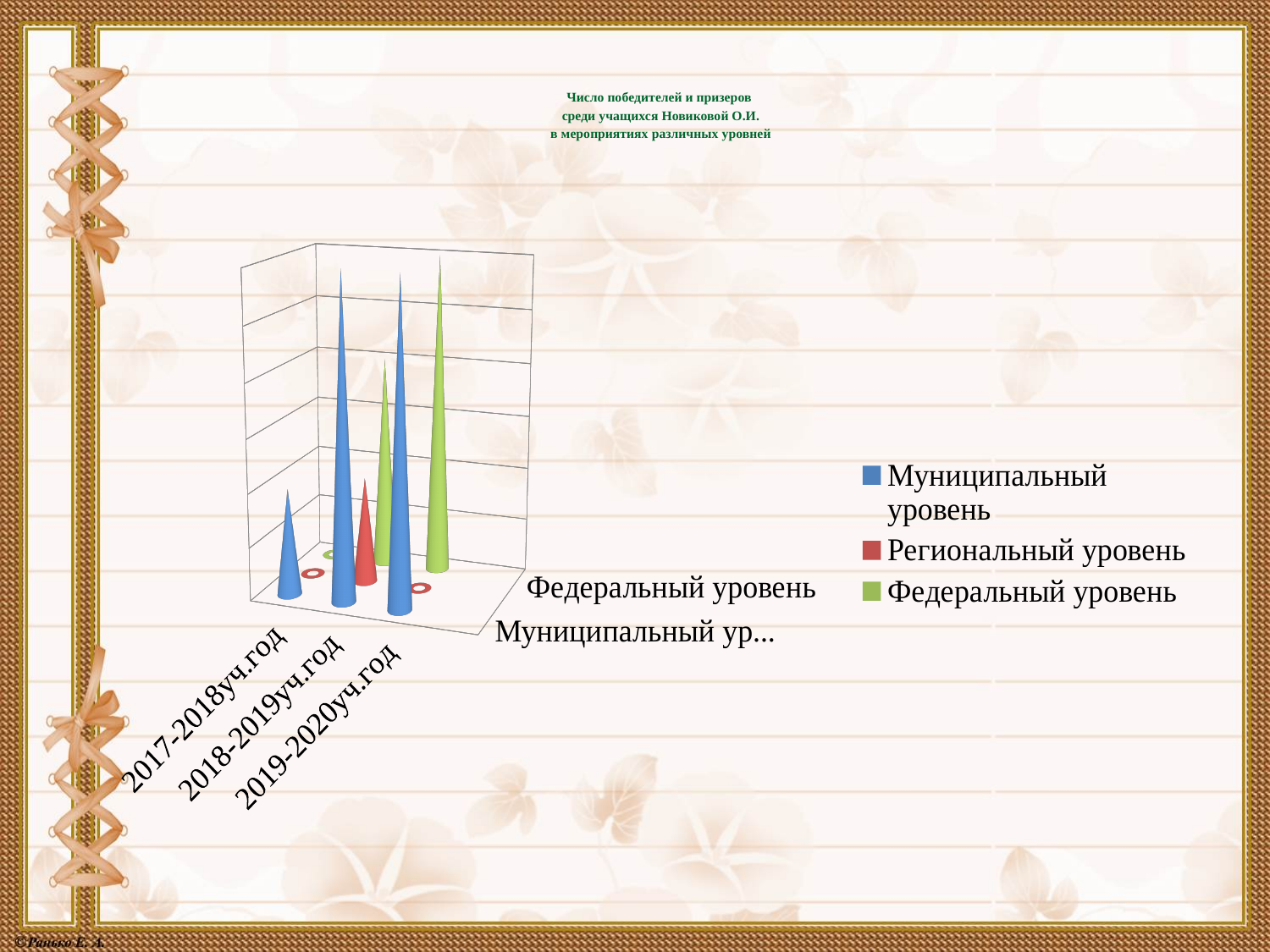
Does the Федеральный уровень value rise or fall from 2017-2018уч.год to 2018-2019уч.год? rises How many series does the chart legend list? 3 What kind of chart is shown on the slide? bar chart What is the title of the chart? Число победителей и призеров среди учащихся Новиковой О.И. в мероприятиях различных уровней For the Федеральный уровень series, which academic year has the lowest value? 2017-2018уч.год In 2018-2019уч.год, which is larger: the Региональный уровень value or the Федеральный уровень value? Федеральный уровень In 2017-2018уч.год, which series has the highest value? Муниципальный уровень Which is larger for Муниципальный уровень: the value in 2017-2018уч.год or in 2018-2019уч.год? 2018-2019уч.год For the Муниципальный уровень series, which academic year has the lowest value? 2017-2018уч.год How many academic-year categories are shown along the x axis of the chart? 3 Which series is shown in blue in the chart legend? Муниципальный уровень For the Региональный уровень series, which academic year has the highest value? 2018-2019уч.год